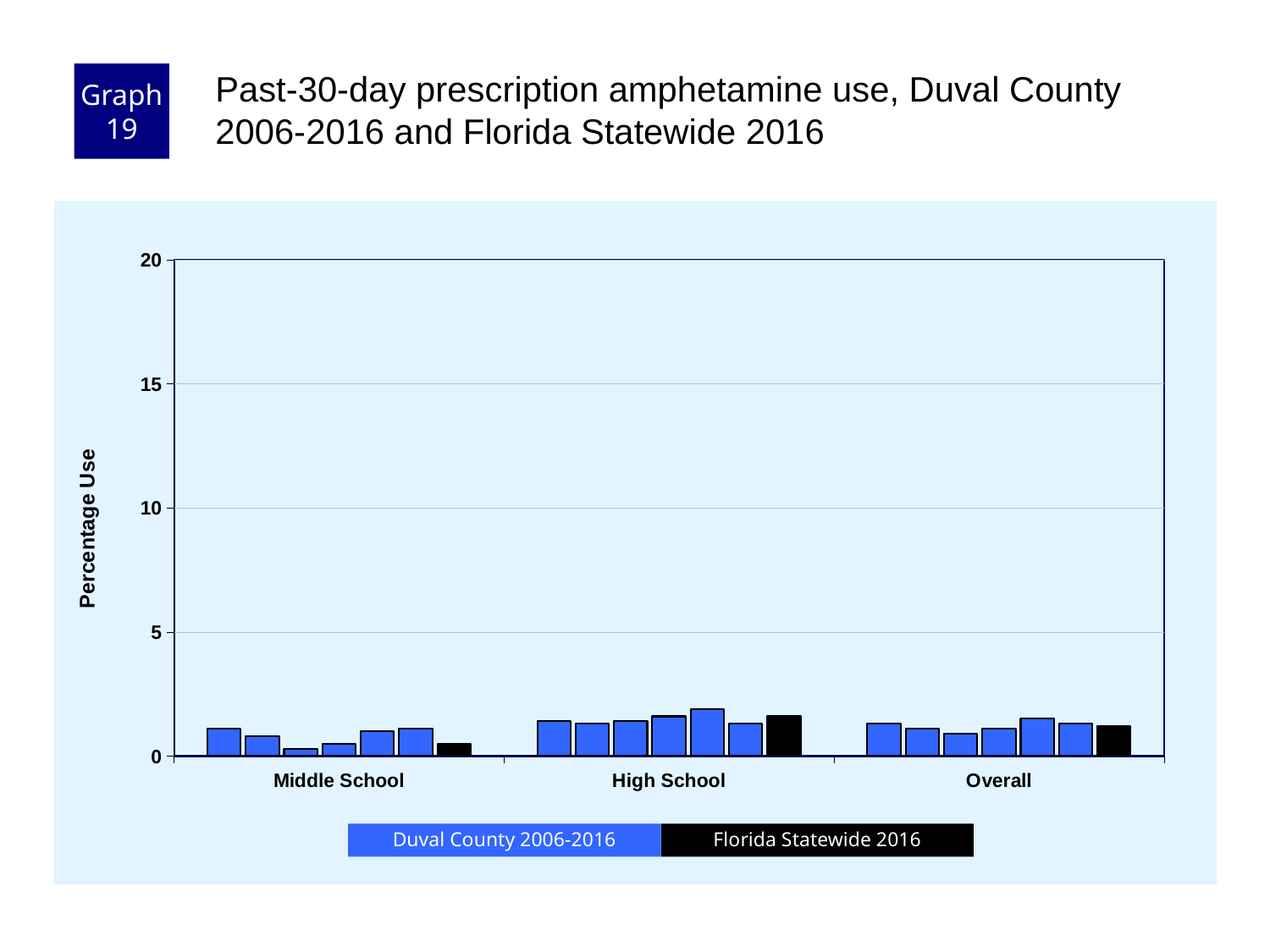
How many series does the legend list? 2 How many categories are shown on the x axis? 3 Is the Florida Statewide 2016 value for Overall greater or less than 5? less Which category contains the tallest bar in the chart? High School What is the label on the y axis? Percentage Use Which category has the lowest Florida Statewide 2016 value? Middle School Is the Florida Statewide 2016 value larger for High School or for Middle School? High School Is the Florida Statewide 2016 value for High School greater or less than 5? less What kind of chart is shown on the slide? bar chart What is the title of the chart? Past-30-day prescription amphetamine use, Duval County 2006-2016 and Florida Statewide 2016 Is the Florida Statewide 2016 value for Middle School greater or less than 5? less Is the Florida Statewide 2016 value larger for Overall or for Middle School? Overall